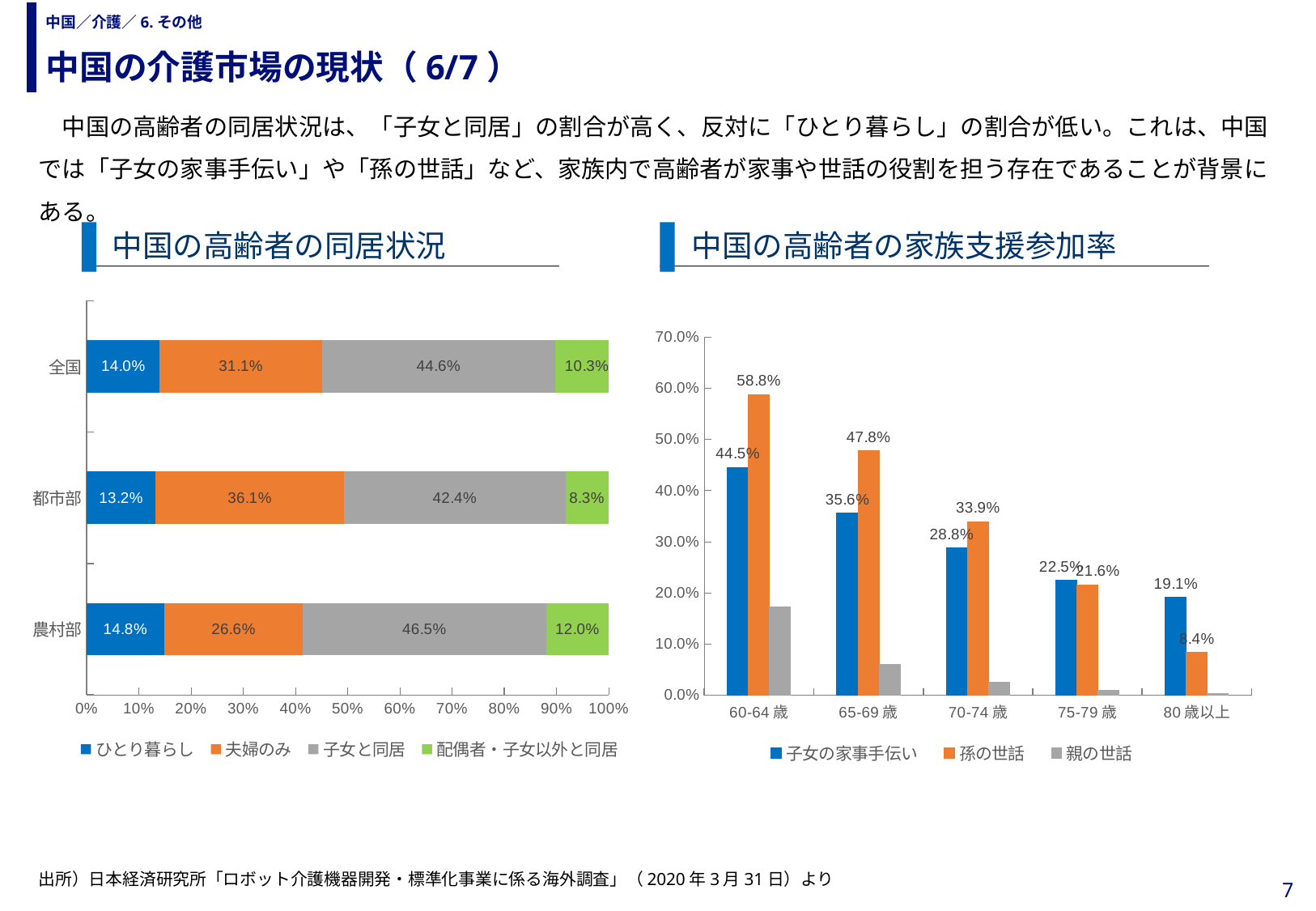
In the chart titled 中国の高齢者の家族支援参加率, what is the value for 孫の世話 in the 60-64 歳 group? 58.8% In the chart titled 中国の高齢者の同居状況, how many series does the legend list? 4 In the chart titled 中国の高齢者の家族支援参加率, is the value for 親の世話 in the 60-64 歳 group greater or less than 20.0%? less In the chart titled 中国の高齢者の同居状況, what kind of chart is it? Stacked bar chart In the chart titled 中国の高齢者の同居状況, what is the difference between the 子女と同居 values for 農村部 and 都市部? 4.1% In the chart titled 中国の高齢者の同居状況, what is the value for 子女と同居 in the 全国 bar? 44.6% In the chart titled 中国の高齢者の家族支援参加率, what is the value for 子女の家事手伝い in the 80 歳以上 group? 19.1% In the chart titled 中国の高齢者の家族支援参加率, how many age groups are shown on the x axis? 5 In the chart titled 中国の高齢者の同居状況, what is the value for ひとり暮らし in the 農村部 bar? 14.8% In the chart titled 中国の高齢者の家族支援参加率, which age group has the lowest value for 孫の世話? 80 歳以上 In the chart titled 中国の高齢者の同居状況, which category has the highest value for 夫婦のみ? 都市部 In the chart titled 中国の高齢者の家族支援参加率, how does the value for 子女の家事手伝い change as age increases along the x axis? It falls